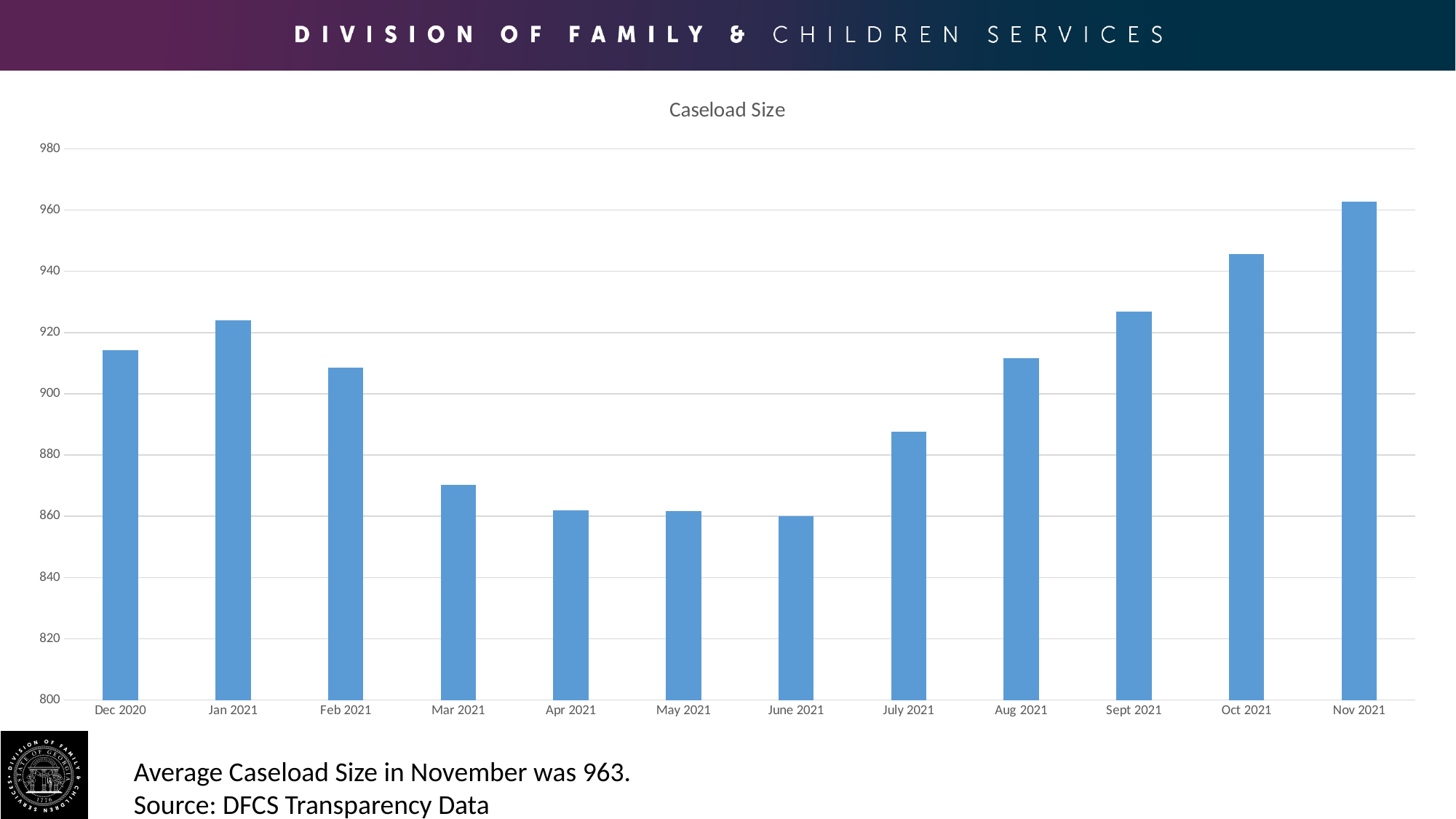
What was the average caseload size in November 2021? 963 What kind of chart is shown on the slide? bar chart Is the caseload size for Dec 2020 greater or less than 900? greater From June 2021 to Nov 2021, do the caseload sizes rise or fall? rise What is the title of the chart? Caseload Size Is the caseload size for July 2021 greater or less than 900? less How many months are plotted on the chart? 12 Which is larger, the caseload size for Jan 2021 or Feb 2021? Jan 2021 Is the caseload size for Mar 2021 greater or less than 880? less Which is larger, the caseload size for Mar 2021 or July 2021? July 2021 Which month has the highest caseload size? Nov 2021